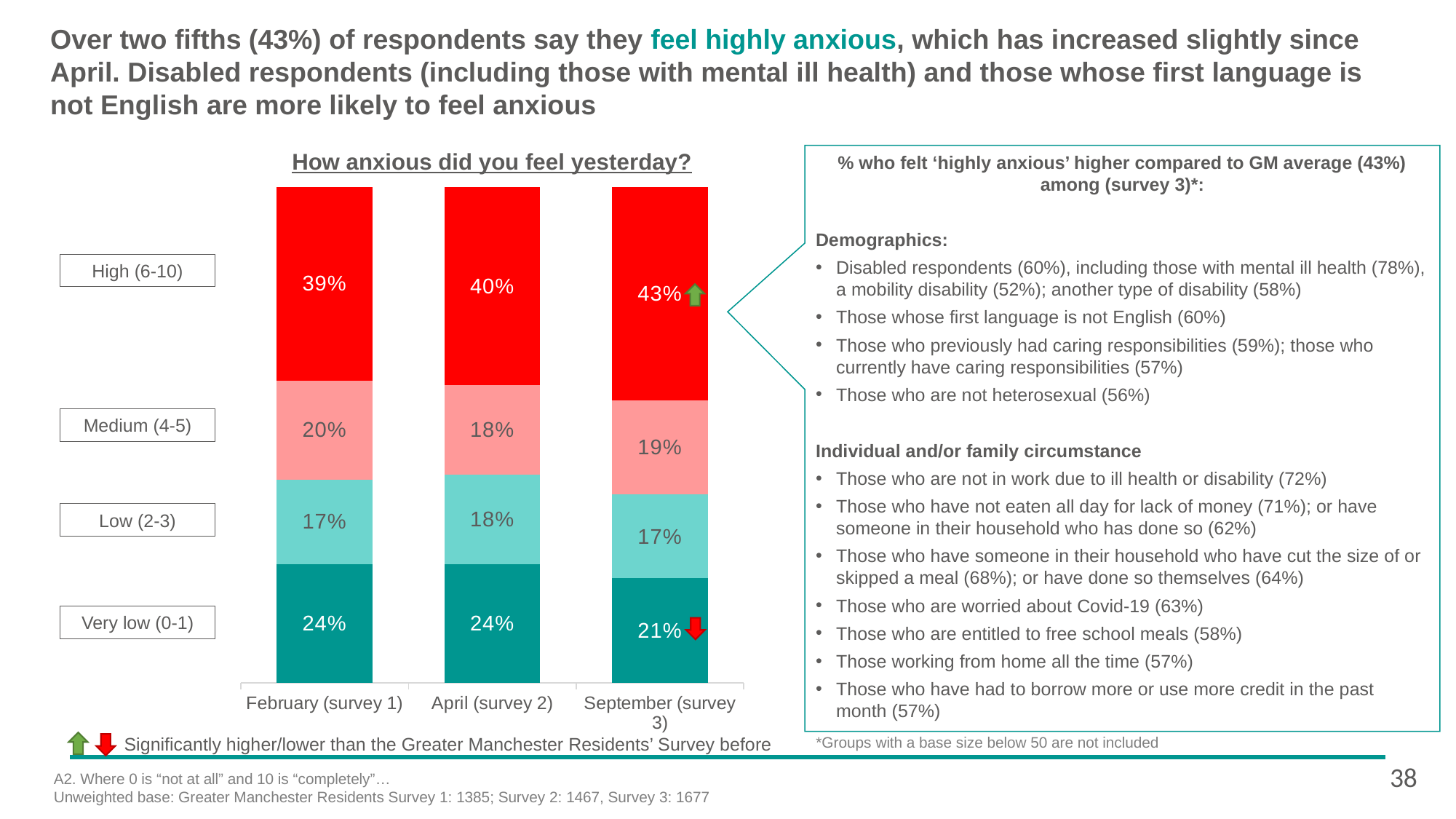
How many survey waves (bars) are shown on the x axis of the chart? 3 How does the High (6-10) share change from February (survey 1) to September (survey 3)? It rises What is the title of the chart? How anxious did you feel yesterday? What is the difference in the High (6-10) share between September (survey 3) and February (survey 1)? 4 percentage points How many anxiety level categories (series) are shown in the chart? 4 Which is larger: the Low (2-3) share in April (survey 2) or in September (survey 3)? April (survey 2) What percentage of respondents reported High (6-10) anxiety in September (survey 3)? 43% In which survey wave was the High (6-10) share the largest? September (survey 3) What percentage of respondents reported Medium (4-5) anxiety in April (survey 2)? 18% What percentage of respondents reported Very low (0-1) anxiety in February (survey 1)? 24% What type of chart is shown on the slide? Stacked bar chart In which survey wave was the Very low (0-1) share the smallest? September (survey 3)